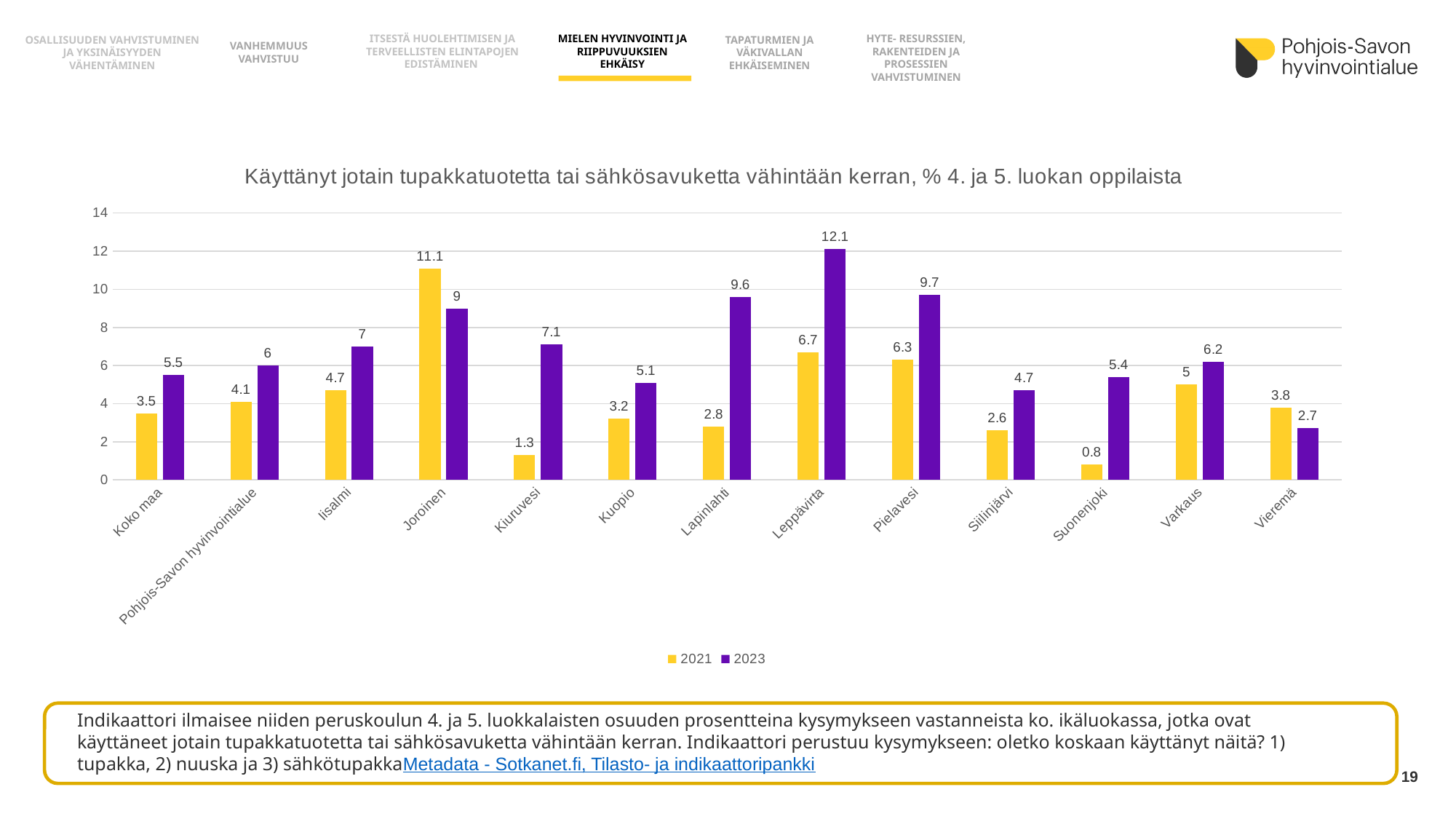
For Vieremä, which is larger: the 2021 value or the 2023 value? 2021 What is the 2021 value for Kiuruvesi? 1.3 What type of chart is shown on the slide? bar chart What is the 2023 value for Leppävirta? 12.1 Which category has the highest 2021 value? Joroinen What is the difference between the 2023 and 2021 values for Kiuruvesi? 5.8 Which category has the lowest 2021 value? Suonenjoki Which colour represents the 2023 series in the chart? purple What is the 2023 value for Pohjois-Savon hyvinvointialue? 6 How many categories are shown on the x axis? 13 How many series does the legend list? 2 Which category has the highest 2023 value? Leppävirta